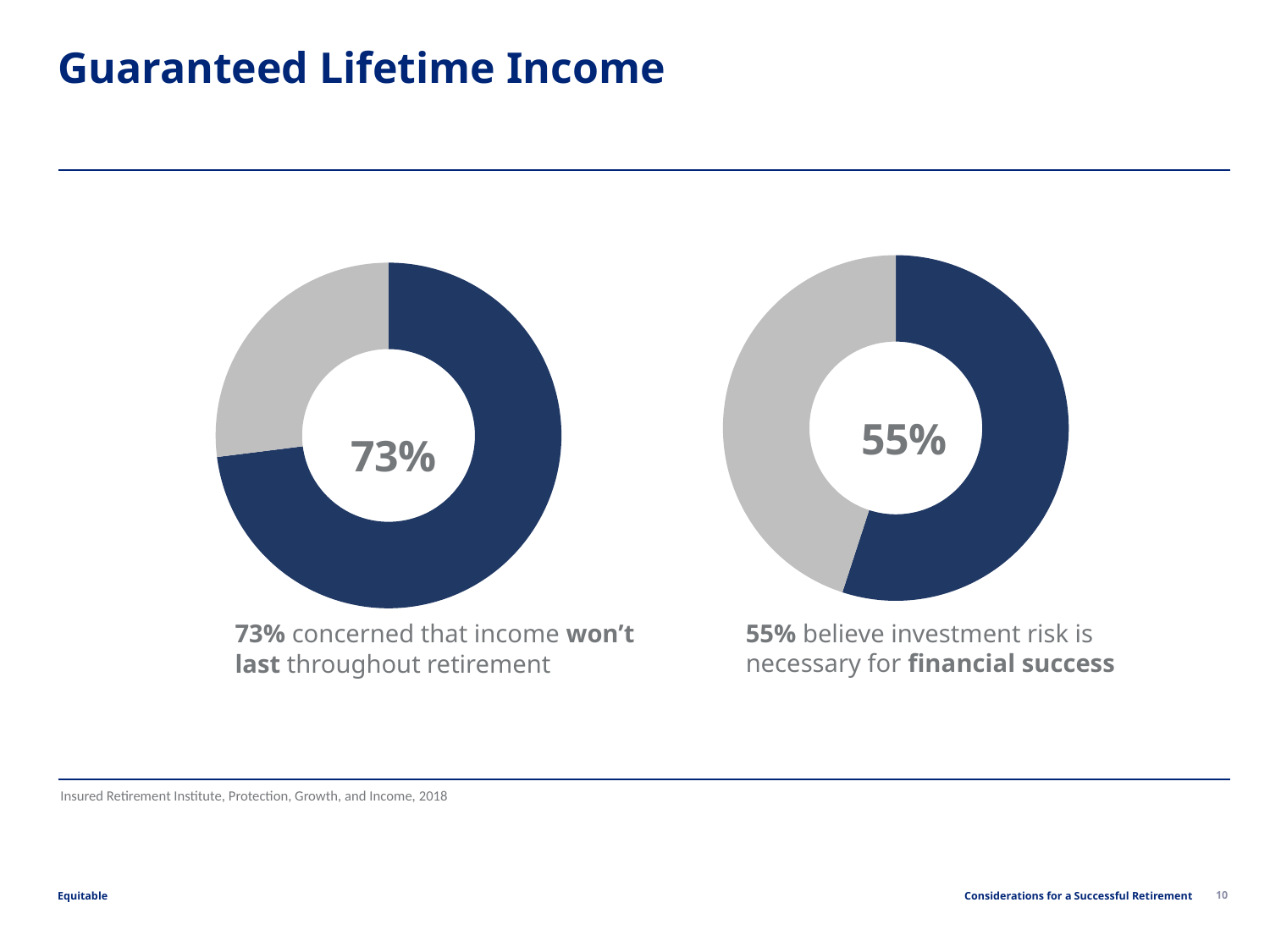
On the left chart, what share of the donut is highlighted in dark blue? 73% What colour is used for the highlighted (73% and 55%) portions of the donut charts? Dark blue What kind of chart is used on this slide to show the 73% and 55% figures? Donut (pie) chart On the right chart, is the highlighted value greater or less than 50%? greater What is the title of the slide containing the two donut charts? Guaranteed Lifetime Income Which chart shows the larger highlighted share: the left chart (income won't last) or the right chart (investment risk necessary)? The left chart (73%) On the left chart, what percentage are concerned that income won't last throughout retirement? 73% What is the difference in percentage points between the left chart's value (73%) and the right chart's value (55%)? 18 percentage points On the right chart, what share of the donut is highlighted in dark blue? 55% On the right chart, what percentage believe investment risk is necessary for financial success? 55% On the left chart, is the highlighted value greater or less than 50%? greater How many donut charts are shown on the slide? 2